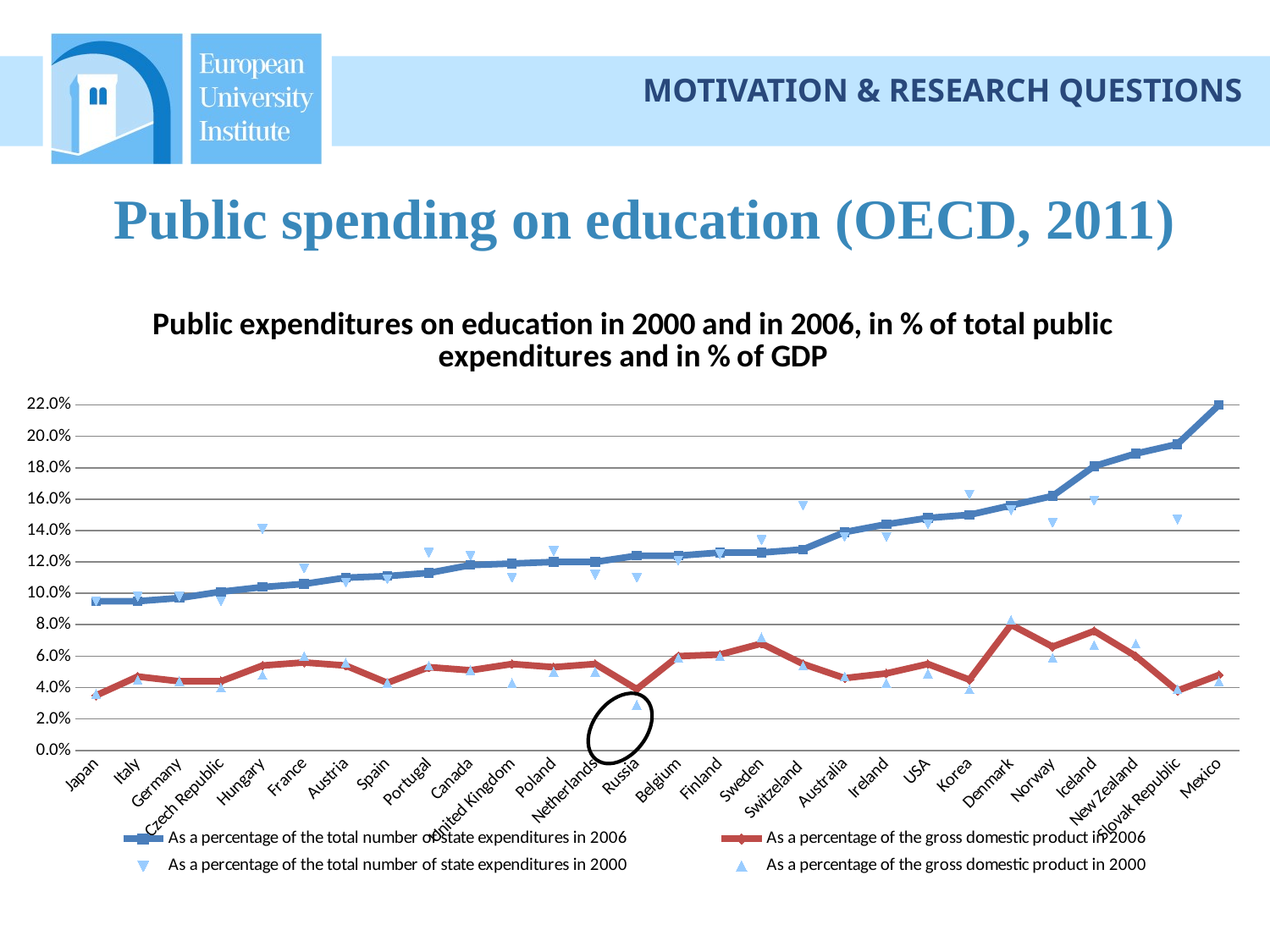
Is the value for Denmark in 'As a percentage of the gross domestic product in 2006' greater or less than 6.0%? greater Does the line for 'As a percentage of the total number of state expenditures in 2006' rise or fall from Japan to Mexico? rise What kind of chart is shown on the slide? line chart Which country on the x axis is circled on the chart? Russia Which country has the highest value for 'As a percentage of the gross domestic product in 2006'? Denmark Is the value for Japan in 'As a percentage of the total number of state expenditures in 2006' greater or less than 10.0%? less Which is larger for 'As a percentage of the gross domestic product in 2006': Denmark or Russia? Denmark How many countries are shown along the x axis? 28 Which country has the highest value for 'As a percentage of the total number of state expenditures in 2006'? Mexico Is the value for Mexico in 'As a percentage of the total number of state expenditures in 2006' greater or less than 20.0%? greater How many series does the legend list? 4